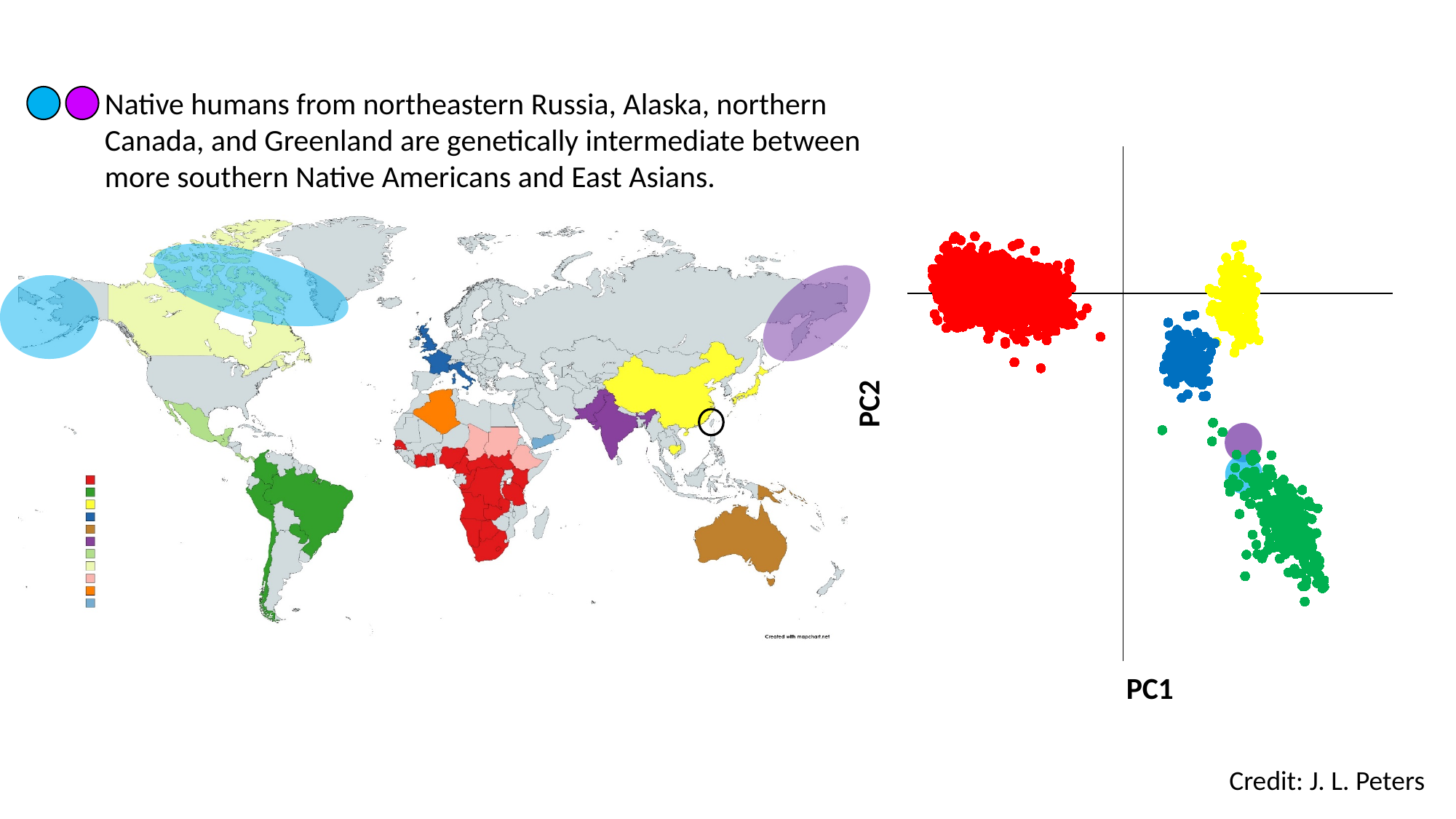
In the scatter plot, which coloured cluster extends lowest along PC2? green In the scatter plot, which coloured cluster lies furthest to the right along PC1? green In the scatter plot, which coloured cluster lies furthest to the left along PC1? red What kind of chart is shown on the right side of the slide? scatter plot In the scatter plot, between which two coloured clusters do the small purple and light-blue circles sit? blue and green What is the label of the vertical axis of the scatter plot? PC2 What is the label of the horizontal axis of the scatter plot? PC1 In the scatter plot, which cluster is lower along PC2, the blue cluster or the yellow cluster? blue In the scatter plot, which cluster is further to the right along PC1, the red cluster or the blue cluster? blue